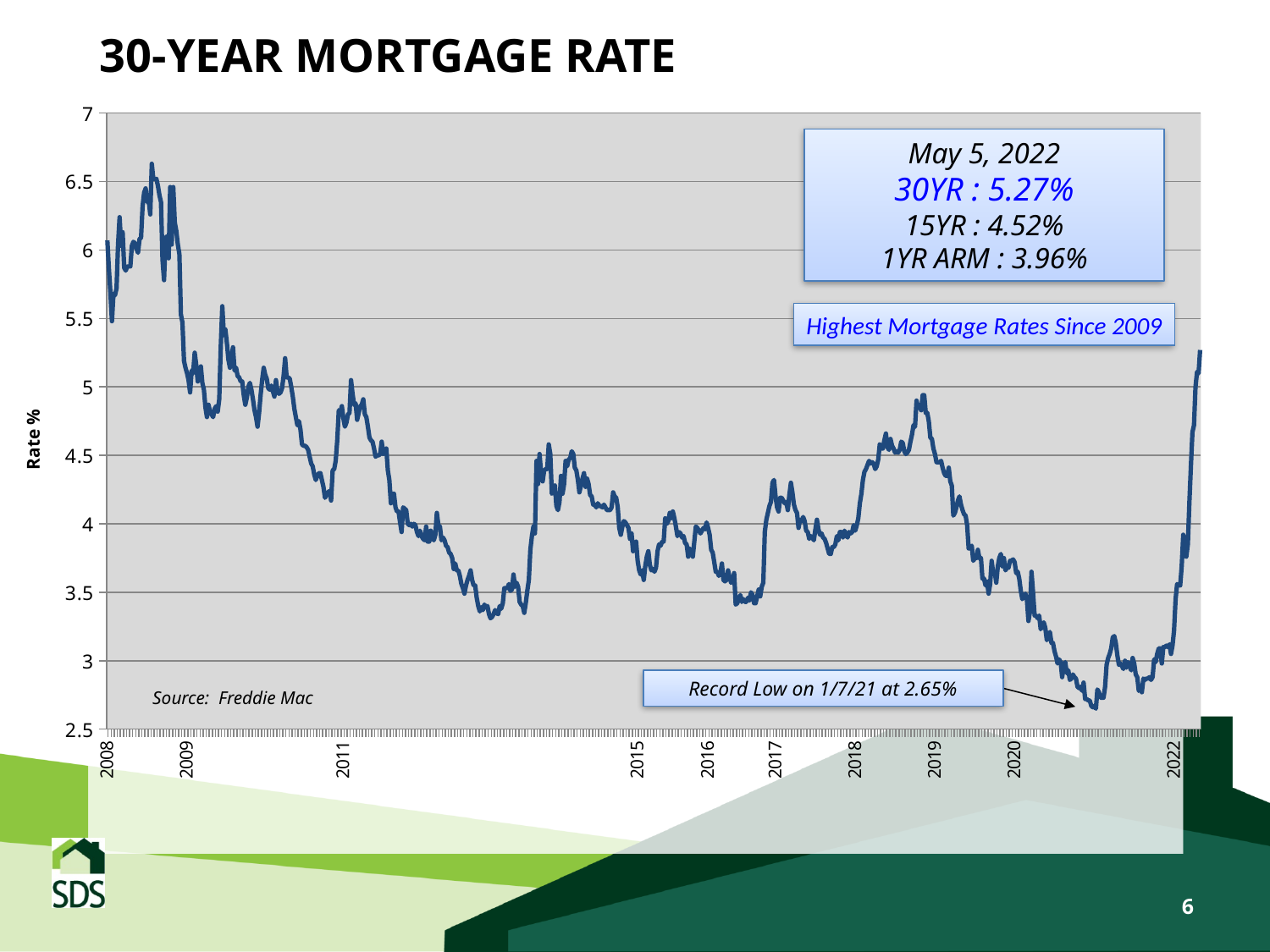
What kind of chart is shown on the slide? line chart Does the 30-year mortgage rate generally rise or fall from 2008 to 2012? fall What was the 30-year mortgage rate on May 5, 2022, according to the annotation? 5.27% How much higher was the 30YR rate than the 15YR rate on May 5, 2022? 0.75% What is the label on the vertical axis of the chart? Rate % How much higher was the 30YR rate on May 5, 2022 than the record low of 1/7/21? 2.62% What was the 1-year ARM rate on May 5, 2022, according to the annotation? 3.96% Is the 30-year mortgage rate at the start of 2008 greater or less than 5.5? greater What was the 15-year mortgage rate on May 5, 2022, according to the annotation? 4.52% What was the record low 30-year mortgage rate noted on the chart? 2.65% What is the title of the chart? 30-YEAR MORTGAGE RATE On what date did the record low of 2.65% occur? 1/7/21